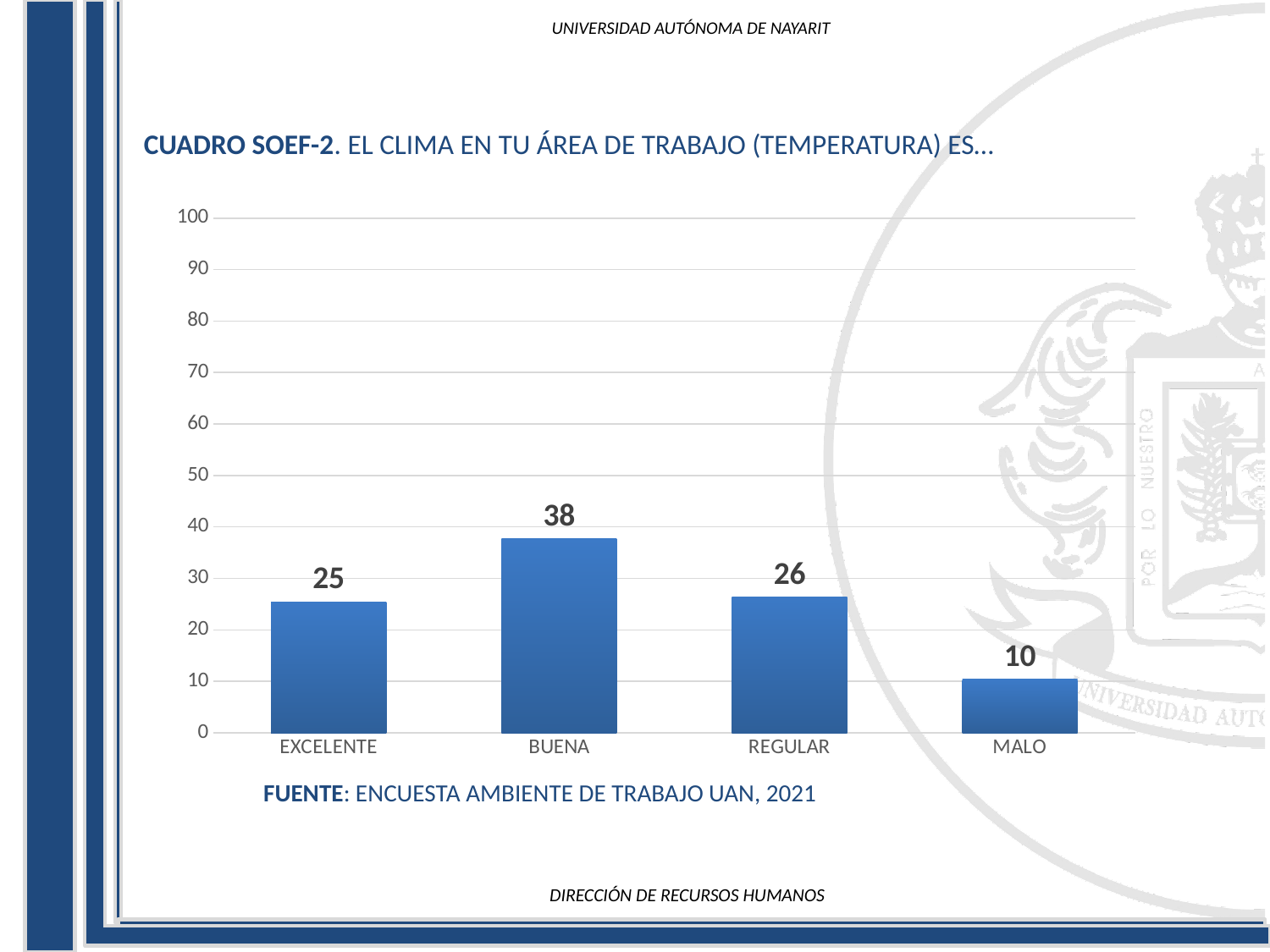
What is the difference between the values for REGULAR and EXCELENTE? 1 Which is larger, the value for BUENA or the value for REGULAR? BUENA How many categories are shown on the x axis? 4 What kind of chart is shown on the slide? bar chart Which category has the lowest value? MALO What is the value for EXCELENTE? 25 What is the value for MALO? 10 What is the difference between the values for BUENA and MALO? 28 What is the value for REGULAR? 26 What source is cited below the chart? ENCUESTA AMBIENTE DE TRABAJO UAN, 2021 Which category has the highest value? BUENA What is the value for BUENA? 38